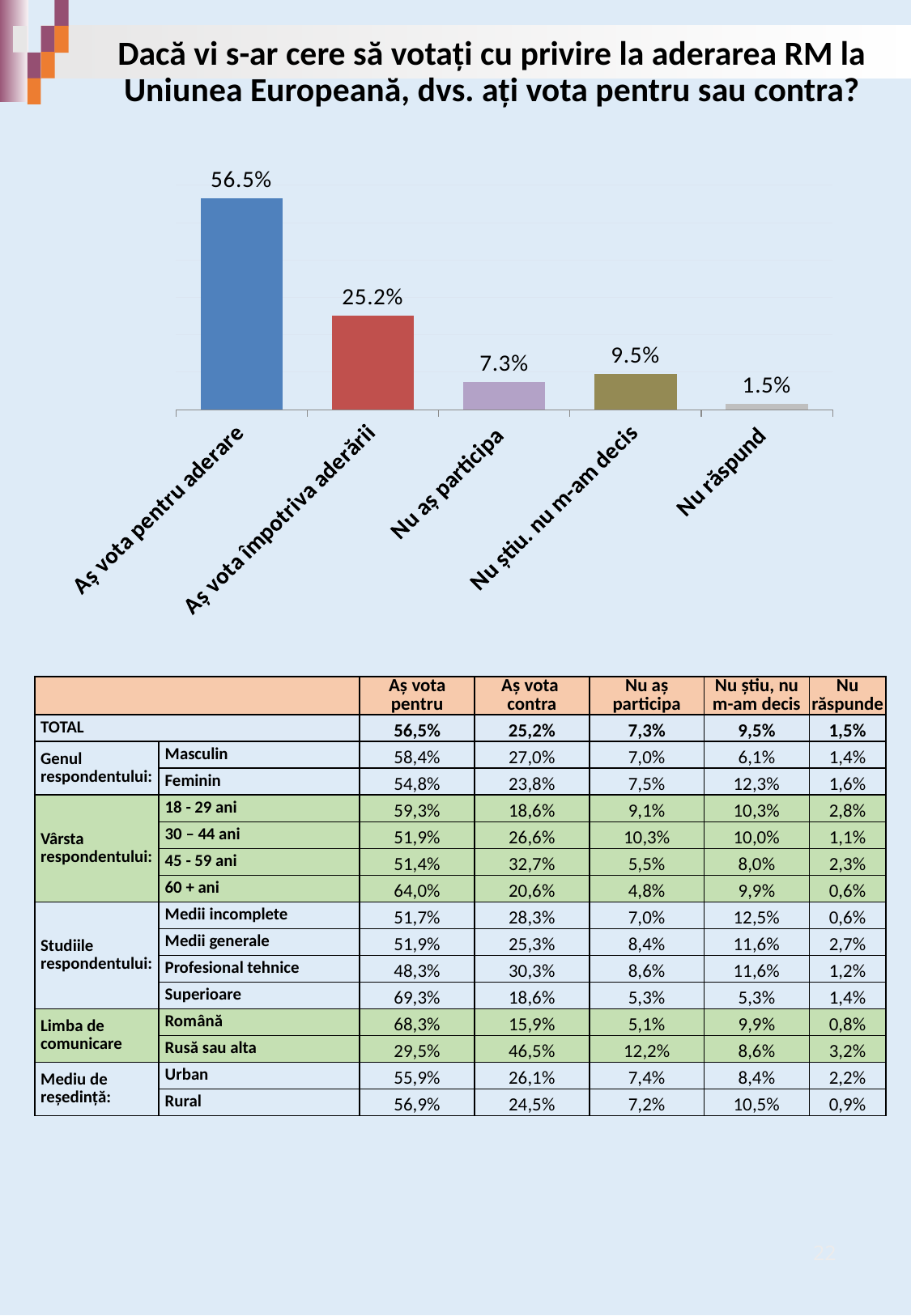
Which is larger, "Nu aș participa" or "Nu știu. nu m-am decis"? Nu știu. nu m-am decis What is the value for "Nu știu. nu m-am decis"? 9.5% What is the value for "Nu aș participa"? 7.3% What kind of chart is shown on the slide? Bar chart Which category has the highest value? Aș vota pentru aderare What is the difference between "Nu știu. nu m-am decis" and "Nu aș participa"? 2.2% What is the value for "Aș vota pentru aderare"? 56.5% What is the value for "Nu răspund"? 1.5% What is the value for "Aș vota împotriva aderării"? 25.2% Which category has the lowest value? Nu răspund What is the difference between "Aș vota pentru aderare" and "Aș vota împotriva aderării"? 31.3% How many categories are shown in the chart? 5